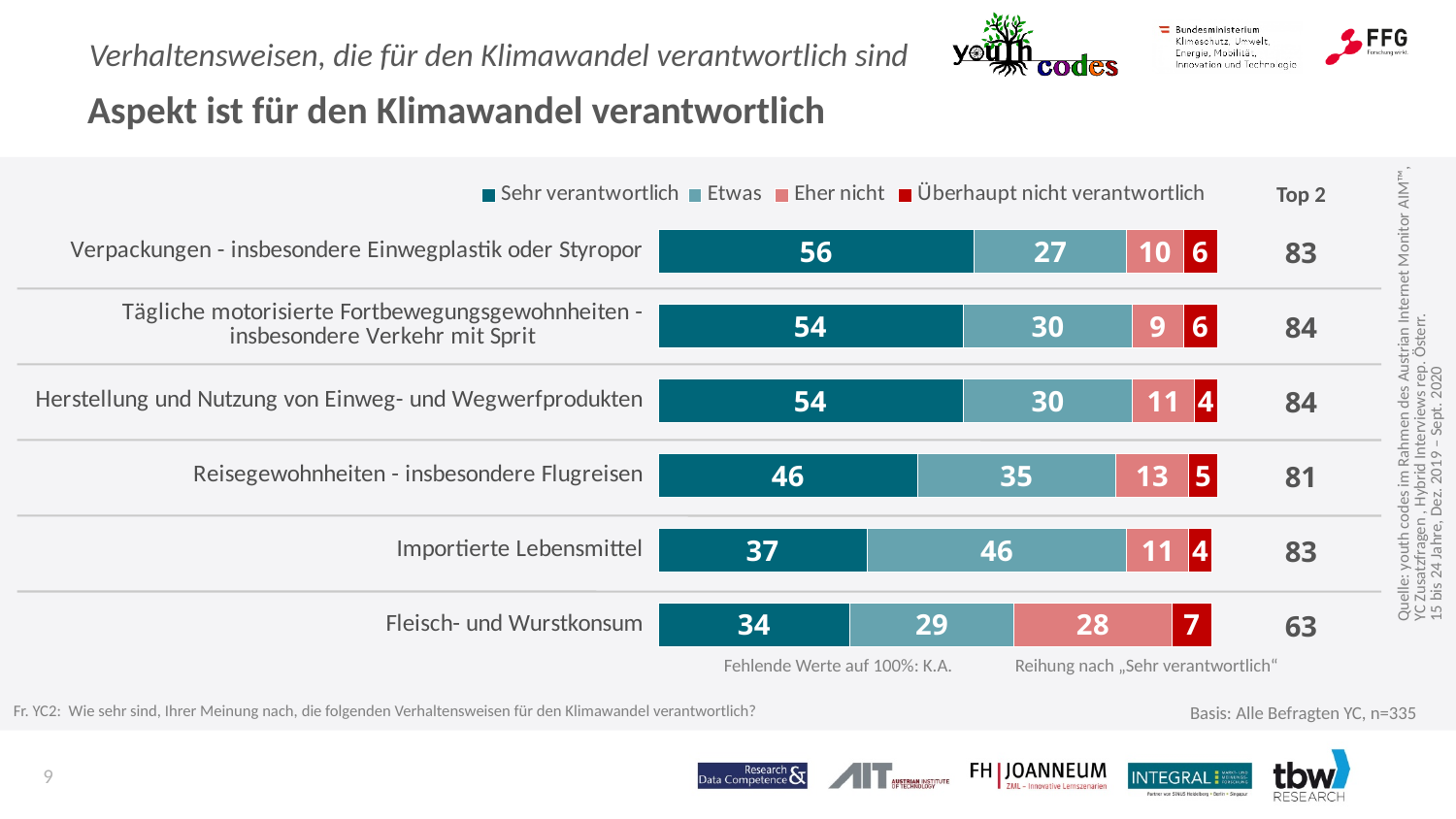
What kind of chart is shown on the slide? Stacked bar chart What is the value for "Sehr verantwortlich" for "Verpackungen - insbesondere Einwegplastik oder Styropor"? 56 What is the "Top 2" value shown for "Fleisch- und Wurstkonsum"? 63 Which has the larger "Etwas" value: "Importierte Lebensmittel" or "Reisegewohnheiten - insbesondere Flugreisen"? Importierte Lebensmittel What is the value for "Eher nicht" for "Fleisch- und Wurstkonsum"? 28 How many series does the legend list? 4 Which category has the lowest value for "Sehr verantwortlich"? Fleisch- und Wurstkonsum How many categories are shown in the chart? 6 Which category has the highest value for "Eher nicht"? Fleisch- und Wurstkonsum What is the difference between the "Sehr verantwortlich" values for "Verpackungen - insbesondere Einwegplastik oder Styropor" and "Fleisch- und Wurstkonsum"? 22 Which category has the highest value for "Sehr verantwortlich"? Verpackungen - insbesondere Einwegplastik oder Styropor What is the value for "Etwas" for "Importierte Lebensmittel"? 46